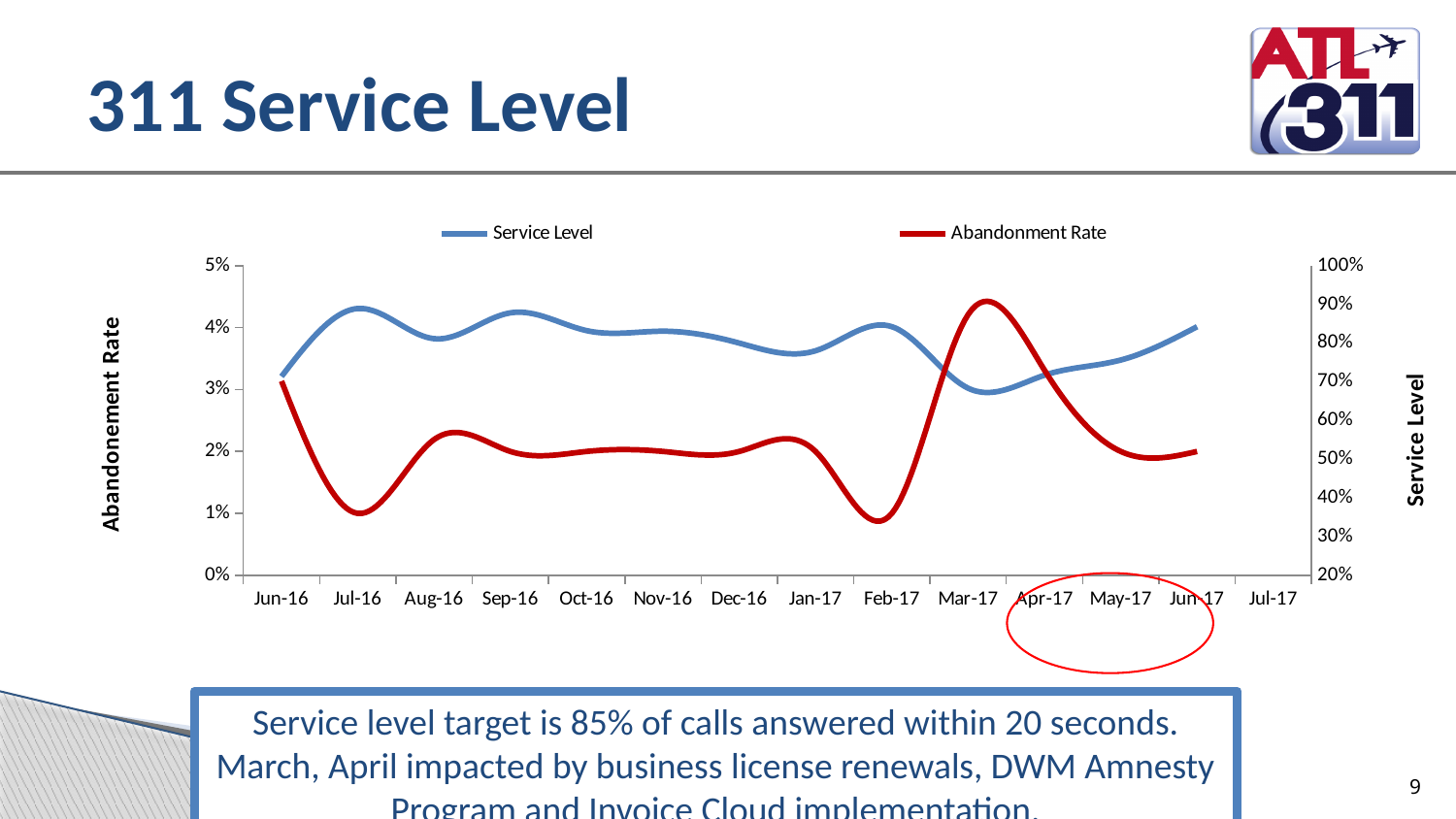
What is the title of the right-hand vertical axis? Service Level In which month does the Abandonment Rate reach its highest value? Mar-17 Does the Service Level rise or fall from Apr-17 to Jun-17? rise Is the Abandonment Rate for Jul-16 greater or less than 2%? less Is the Service Level for Apr-17 greater or less than 80%? less How many series does the chart legend list? 2 Is the Abandonment Rate for Mar-17 greater or less than 4%? greater Which series is plotted in red? Abandonment Rate What kind of chart is shown on the slide? line chart Which is larger, the Abandonment Rate in Mar-17 or in Jun-17? Mar-17 How many month labels are shown on the x axis? 14